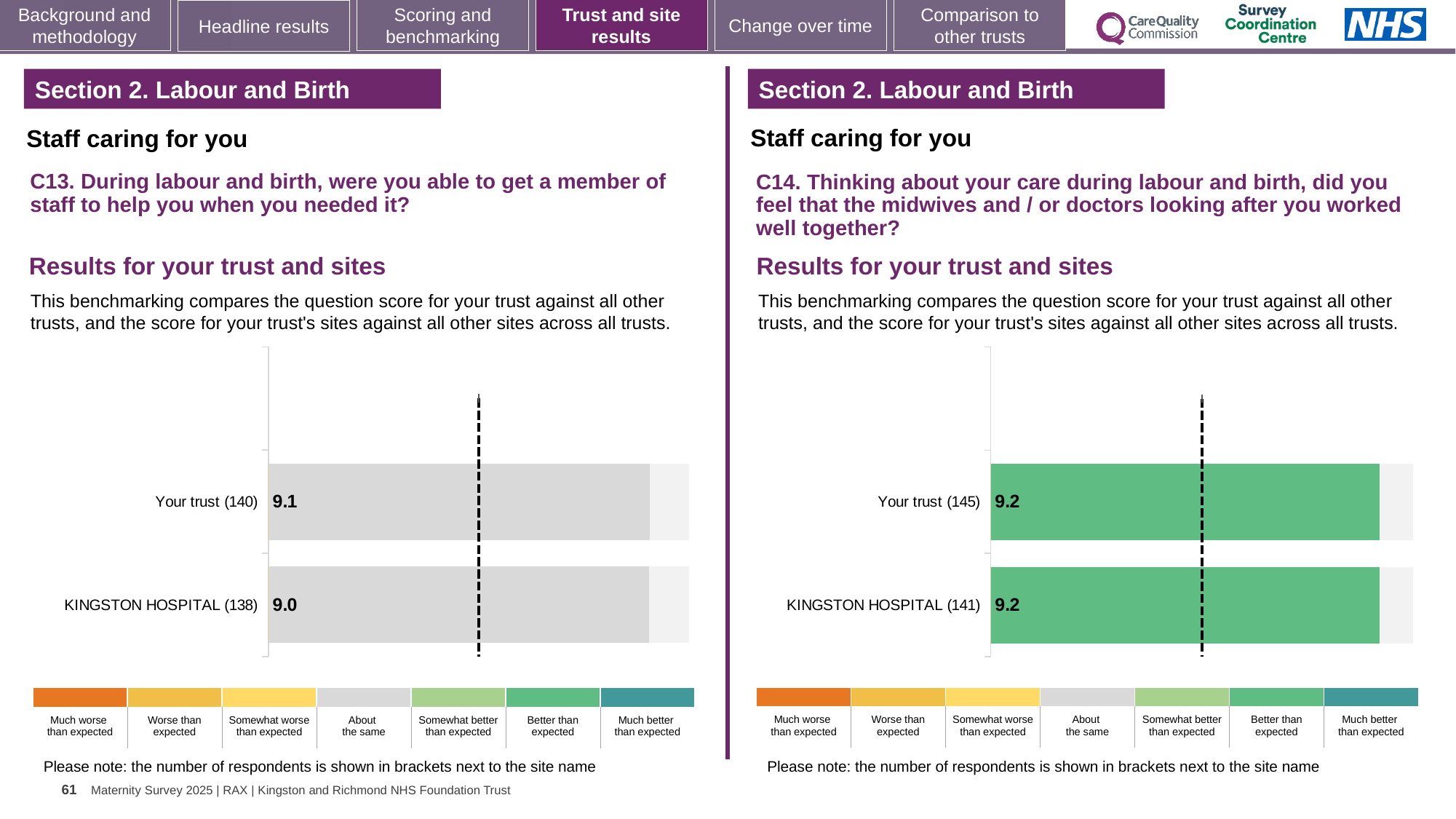
In the C13 chart on the left, which has the higher score, Your trust or KINGSTON HOSPITAL? Your trust In the C14 chart on the right, how many respondents are shown in brackets for Your trust? 145 In the C14 chart on the right, what is the difference between the score for Your trust and the score for KINGSTON HOSPITAL? 0 In the C13 chart on the left, what is the score for KINGSTON HOSPITAL? 9.0 In the C14 chart on the right, what is the score for Your trust? 9.2 In the C14 chart on the right, what is the score for KINGSTON HOSPITAL? 9.2 In the C13 chart on the left, what is the difference between the score for Your trust and the score for KINGSTON HOSPITAL? 0.1 In the C13 chart on the left, how many respondents are shown in brackets for KINGSTON HOSPITAL? 138 What kind of chart is used for the C14 results on the right? Bar chart In the C13 chart on the left, what is the score for Your trust? 9.1 How many bars are plotted in the C13 chart on the left? 2 According to the colour key, which benchmark category do the green bars in the C14 chart on the right represent? Better than expected